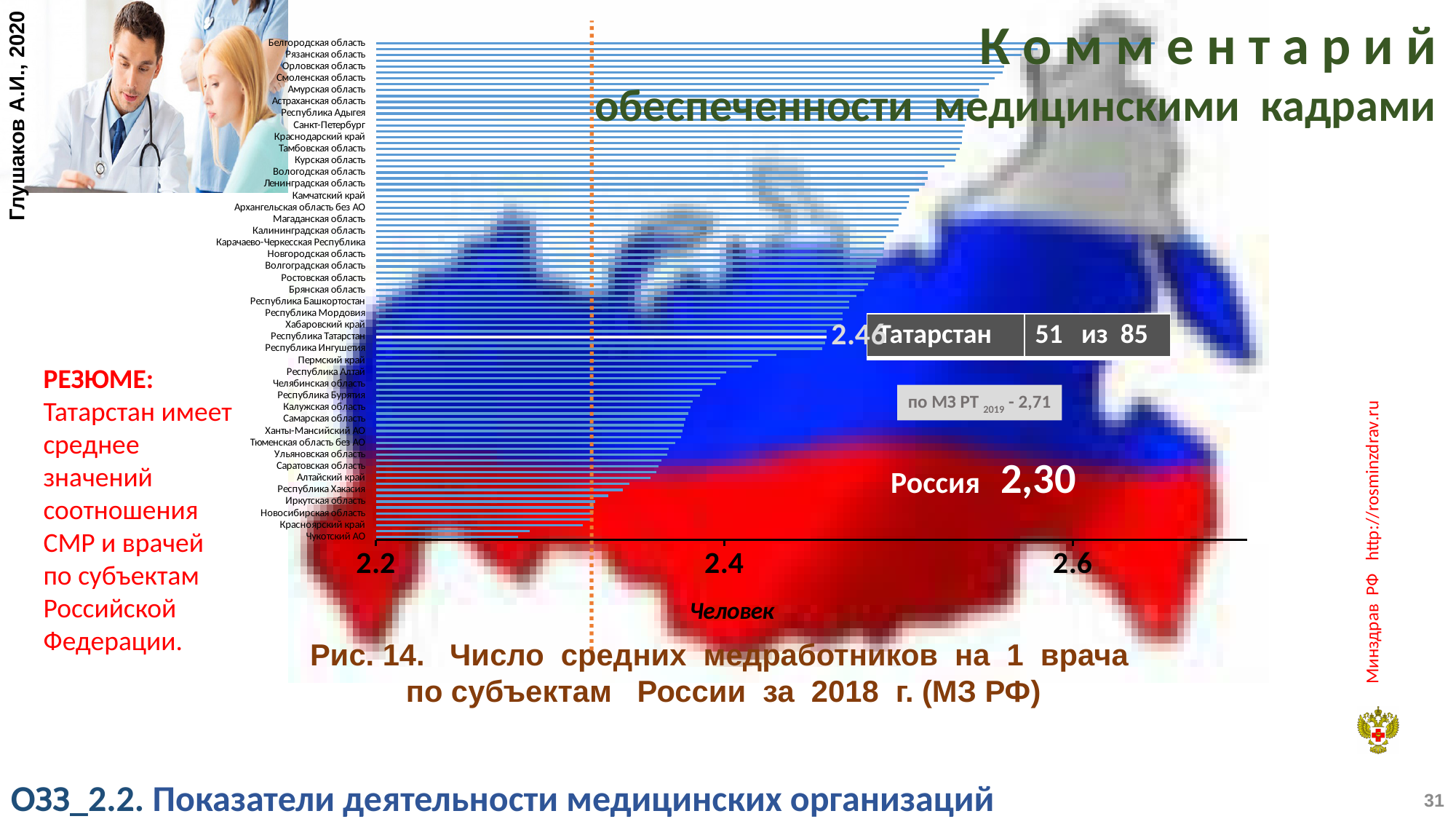
What value is given for Россия on the slide? 2,30 What kind of chart is shown on the slide? bar chart Is the value for Республика Татарстан greater or less than 2.4? greater Which region has the highest number of mid-level medical workers per doctor in the chart? Белгородская область Is the value for Санкт-Петербург greater or less than 2.4? greater Is the value for Белгородская область greater or less than 2.6? greater Which has a larger value, Рязанская область or Красноярский край? Рязанская область Which region has the lowest number of mid-level medical workers per doctor in the chart? Чукотский АО What is the label of the horizontal axis of the chart? Человек What is the title of the figure (Рис. 14)? Число средних медработников на 1 врача по субъектам России за 2018 г. (МЗ РФ)